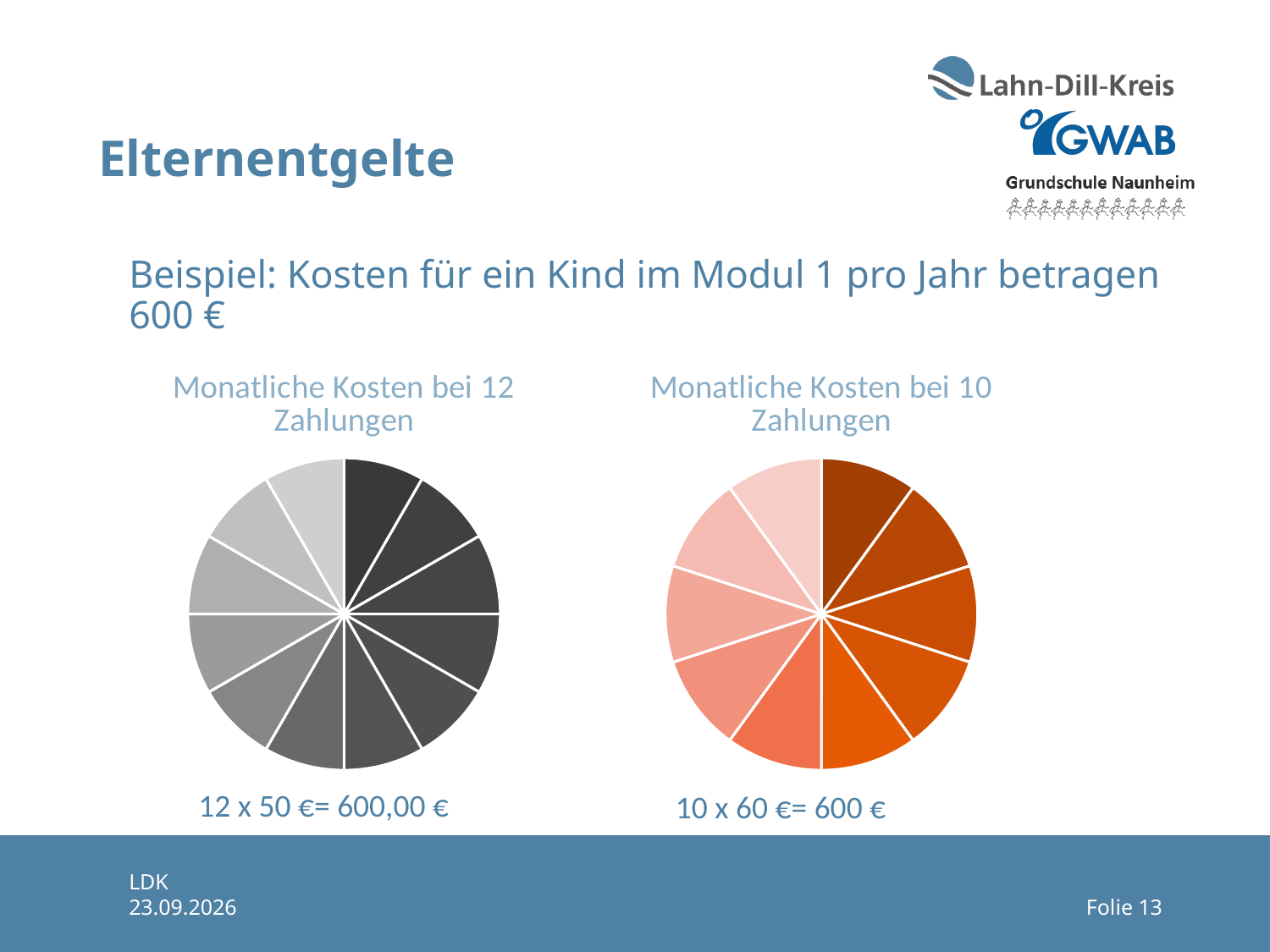
What is the title of the pie chart on the left of the slide? Monatliche Kosten bei 12 Zahlungen How many pie charts are shown on the slide? 2 What colour scheme is used for the slices of the pie chart titled "Monatliche Kosten bei 10 Zahlungen"? Shades of orange According to the text below the chart titled "Monatliche Kosten bei 10 Zahlungen", what is the monthly payment amount? 60 € According to the text below the chart titled "Monatliche Kosten bei 12 Zahlungen", what is the monthly payment amount? 50 € How many slices does the pie chart titled "Monatliche Kosten bei 12 Zahlungen" have? 12 What kind of chart is the chart titled "Monatliche Kosten bei 10 Zahlungen"? Pie chart Are the slices in the pie chart titled "Monatliche Kosten bei 12 Zahlungen" all the same size? Yes Which of the two pie charts on the slide has more slices, the left one or the right one? The left one How many slices does the pie chart titled "Monatliche Kosten bei 10 Zahlungen" have? 10 According to the text below the chart titled "Monatliche Kosten bei 12 Zahlungen", what is the total of the 12 payments? 600,00 € What kind of chart is the chart titled "Monatliche Kosten bei 12 Zahlungen"? Pie chart